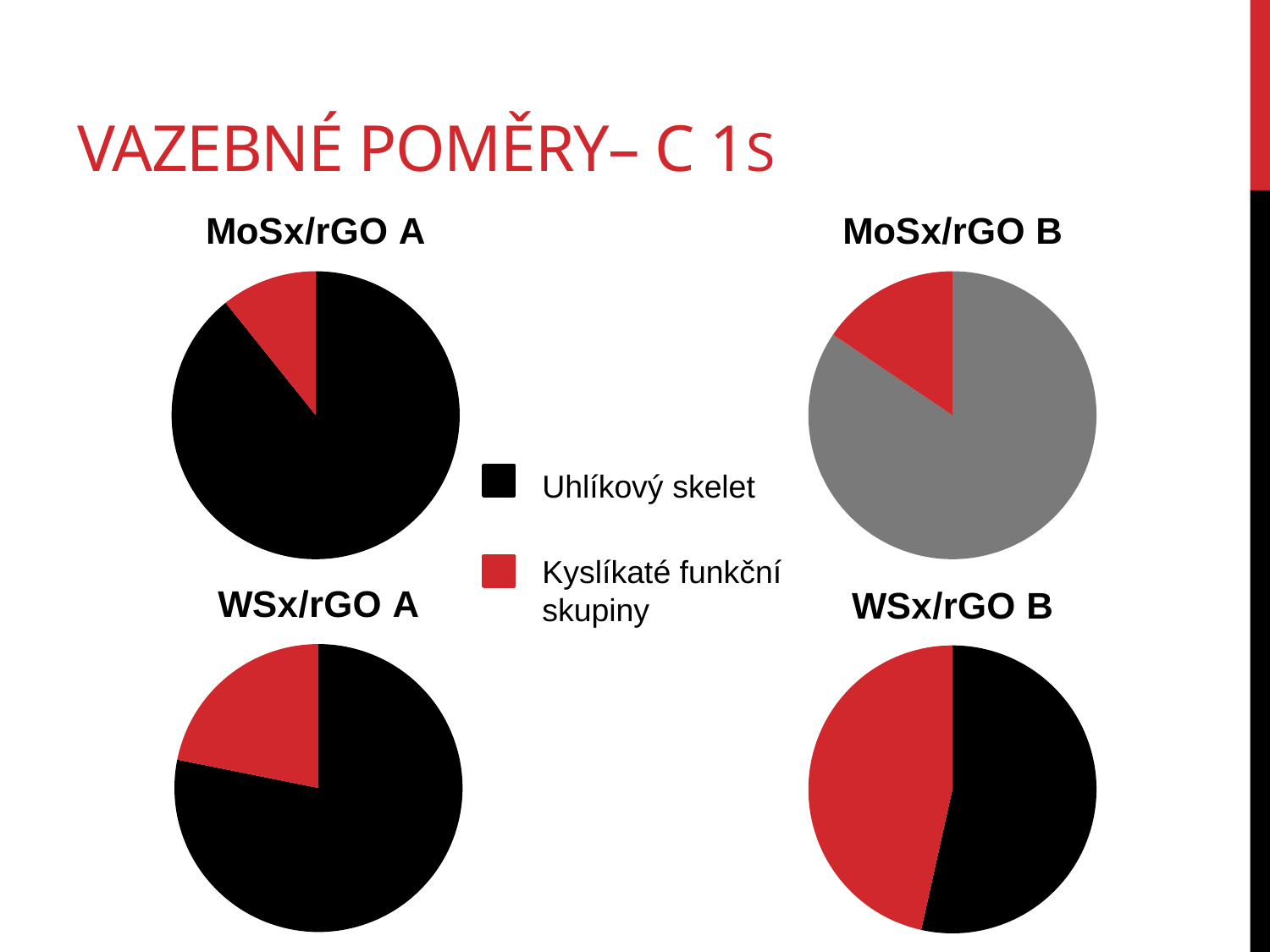
How many entries does the legend list? 2 How many slices does the WSx/rGO A pie chart have? 2 What is the title of the pie chart in the bottom right of the slide? WSx/rGO B Which colour represents Kyslíkaté funkční skupiny in the legend? red Which of the four pie charts has the smallest share of Kyslíkaté funkční skupiny? MoSx/rGO A In the WSx/rGO A pie chart, which category has the largest slice? Uhlíkový skelet Which of the four pie charts has the largest share of Kyslíkaté funkční skupiny? WSx/rGO B In the MoSx/rGO A pie chart, which slice is larger, Uhlíkový skelet or Kyslíkaté funkční skupiny? Uhlíkový skelet How many pie charts are shown on the slide? 4 What kind of chart is used for MoSx/rGO A? pie chart In the MoSx/rGO B pie chart, which category has the smallest slice? Kyslíkaté funkční skupiny